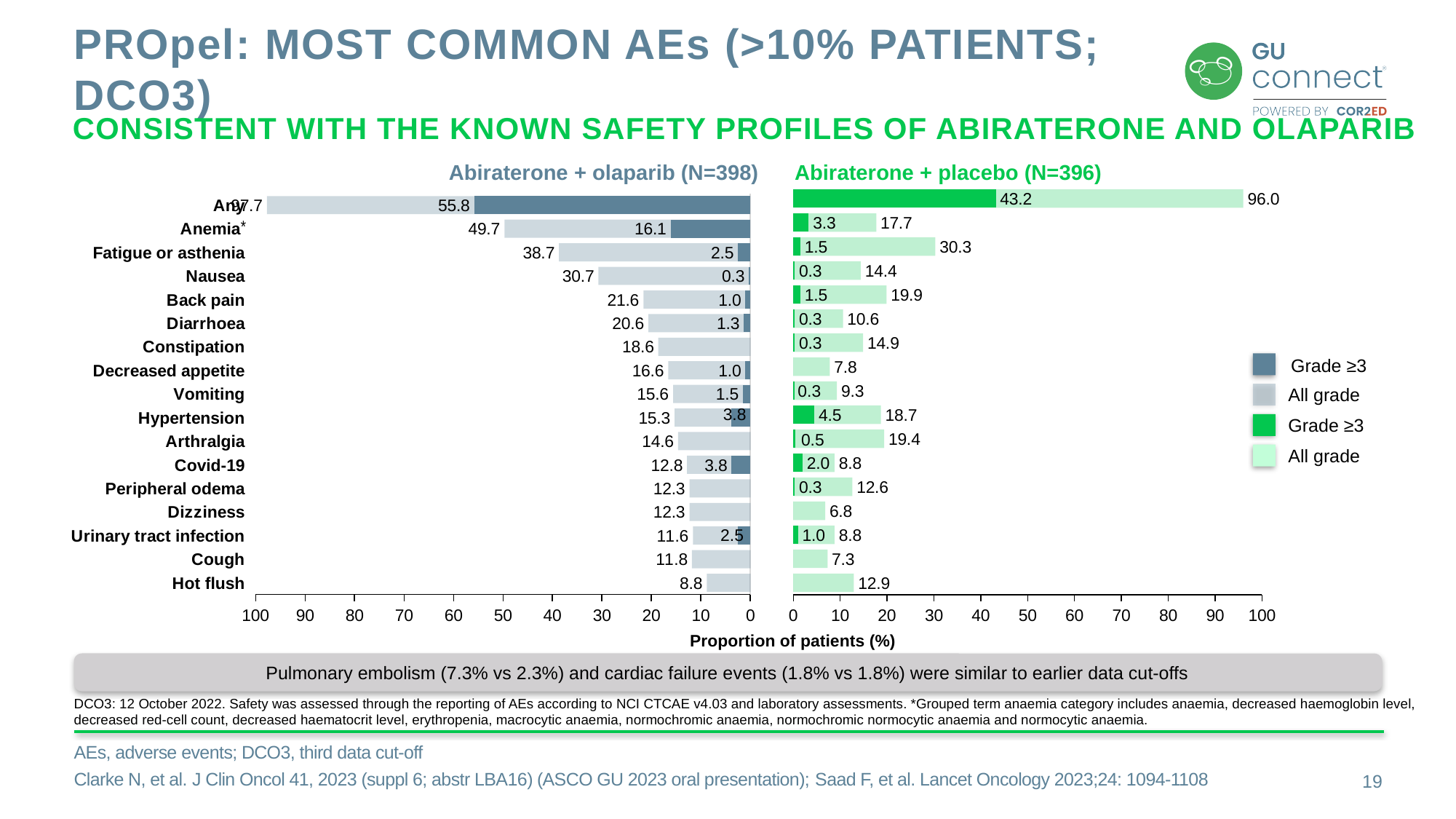
Which is larger: the all-grade Nausea value in the Abiraterone + olaparib chart or in the Abiraterone + placebo chart? Abiraterone + olaparib In the Abiraterone + placebo (N=396) chart, what is the Grade ≥3 value for Any adverse event? 43.2 How many adverse event categories are listed on the y axis of the charts? 17 In the Abiraterone + olaparib (N=398) chart, what is the Grade ≥3 value for Hypertension? 3.8 In the Abiraterone + placebo (N=396) chart, what is the all-grade value for Fatigue or asthenia? 30.3 In the Abiraterone + placebo (N=396) chart, is the all-grade value for Hot flush greater or less than 10? greater In the Abiraterone + olaparib (N=398) chart, what is the all-grade value for Anemia? 49.7 What kind of chart is used on this slide? Bar chart In the Abiraterone + olaparib (N=398) chart, which adverse event has the lowest all-grade value? Hot flush How many entries does the legend list? 4 In the Abiraterone + olaparib (N=398) chart, which adverse event (excluding Any) has the highest all-grade value? Anemia What is the difference between the all-grade Anemia values in the Abiraterone + olaparib chart (49.7) and the Abiraterone + placebo chart (17.7)? 32.0